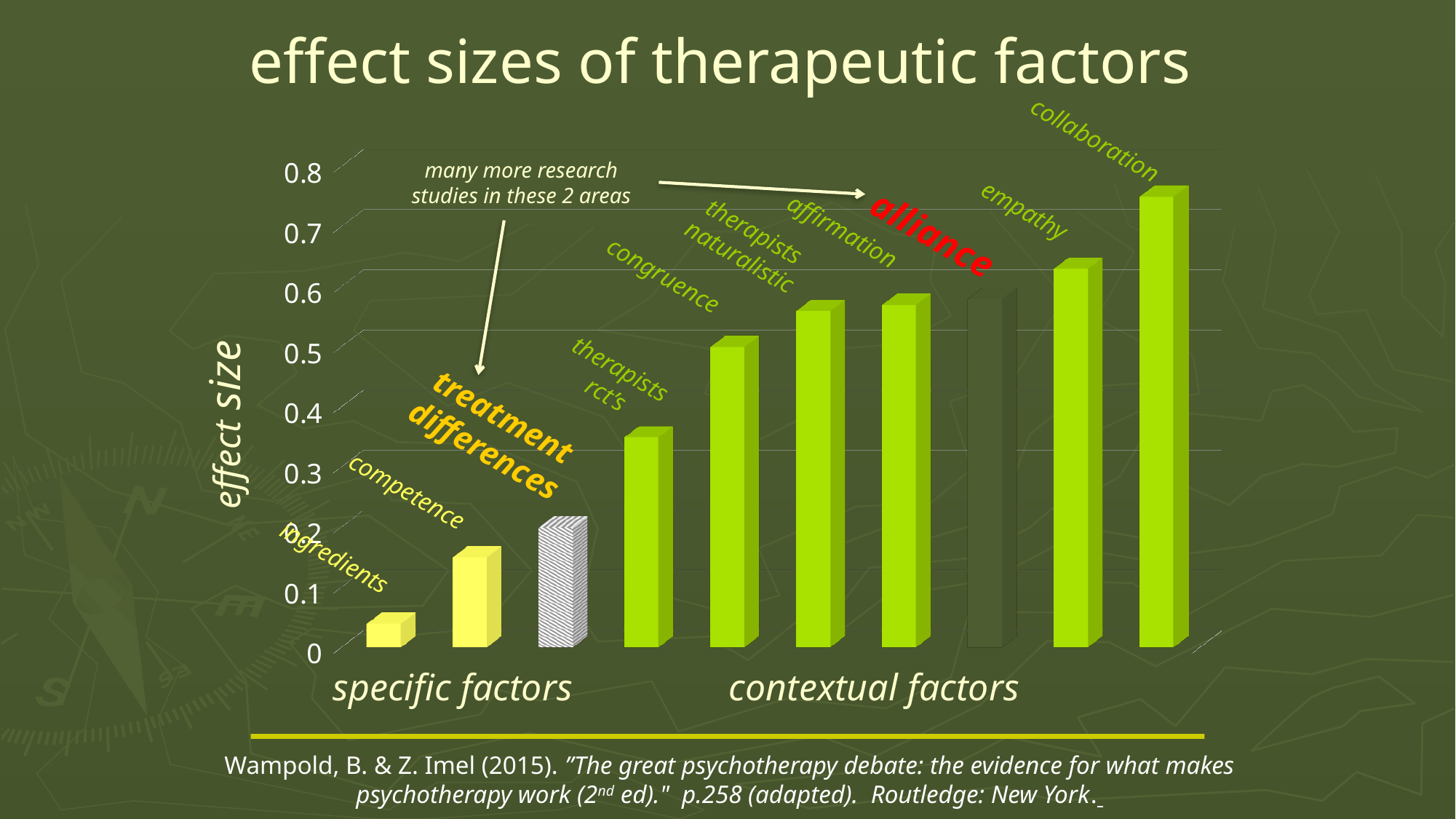
Which has the larger effect size, empathy or competence? empathy What are the two groups of factors named beneath the bars? specific factors and contextual factors Which therapeutic factor has the largest effect size in the chart? collaboration Is the effect size for empathy greater or less than 0.6? greater Which therapeutic factor has the smallest effect size in the chart? ingredients Is the effect size for collaboration greater or less than 0.7? greater What is the label on the vertical axis of the chart? effect size What kind of chart is shown on the slide? bar chart Is the effect size for therapists rct's greater or less than 0.3? greater Do the effect sizes rise or fall moving from left to right across the chart? rise How many bars are plotted in the chart? 10